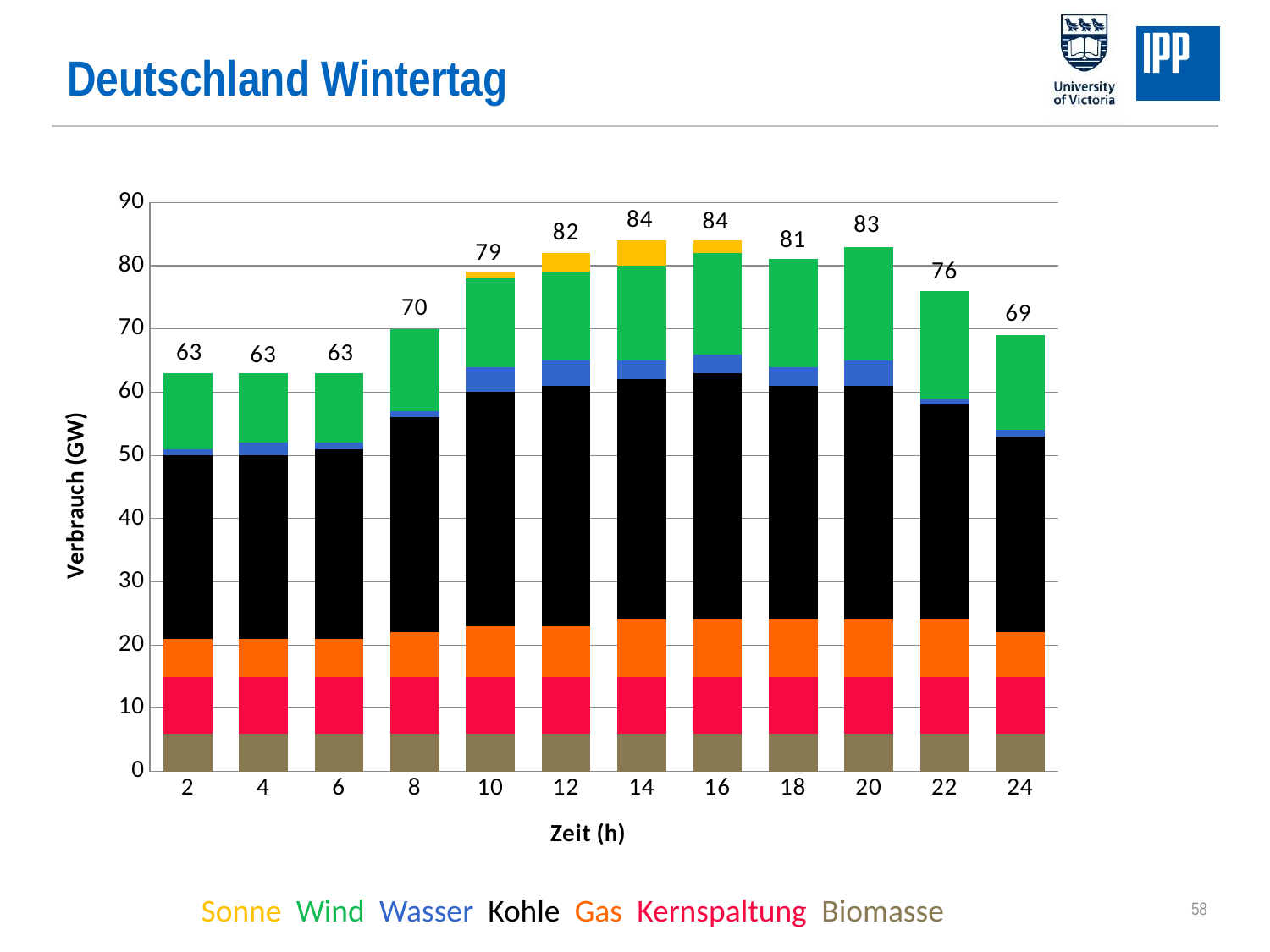
What is the total value labelled on the bar for hour 8? 70 Is the Biomasse segment of the bar at hour 12 greater or less than 10? less What is the total value labelled on the bar for hour 22? 76 Which hours have the lowest labelled total? 2, 4 and 6 Do the labelled totals rise or fall from hour 2 to hour 14? rise How many series does the legend list? 7 What kind of chart is shown on the slide? stacked bar chart Which hours have the highest labelled total? 14 and 16 What is the total value labelled on the bar for hour 14? 84 How many bars (time points) are shown on the x axis? 12 Which has the larger labelled total, hour 20 or hour 24? hour 20 What is the difference between the labelled total at hour 16 and the labelled total at hour 2? 21